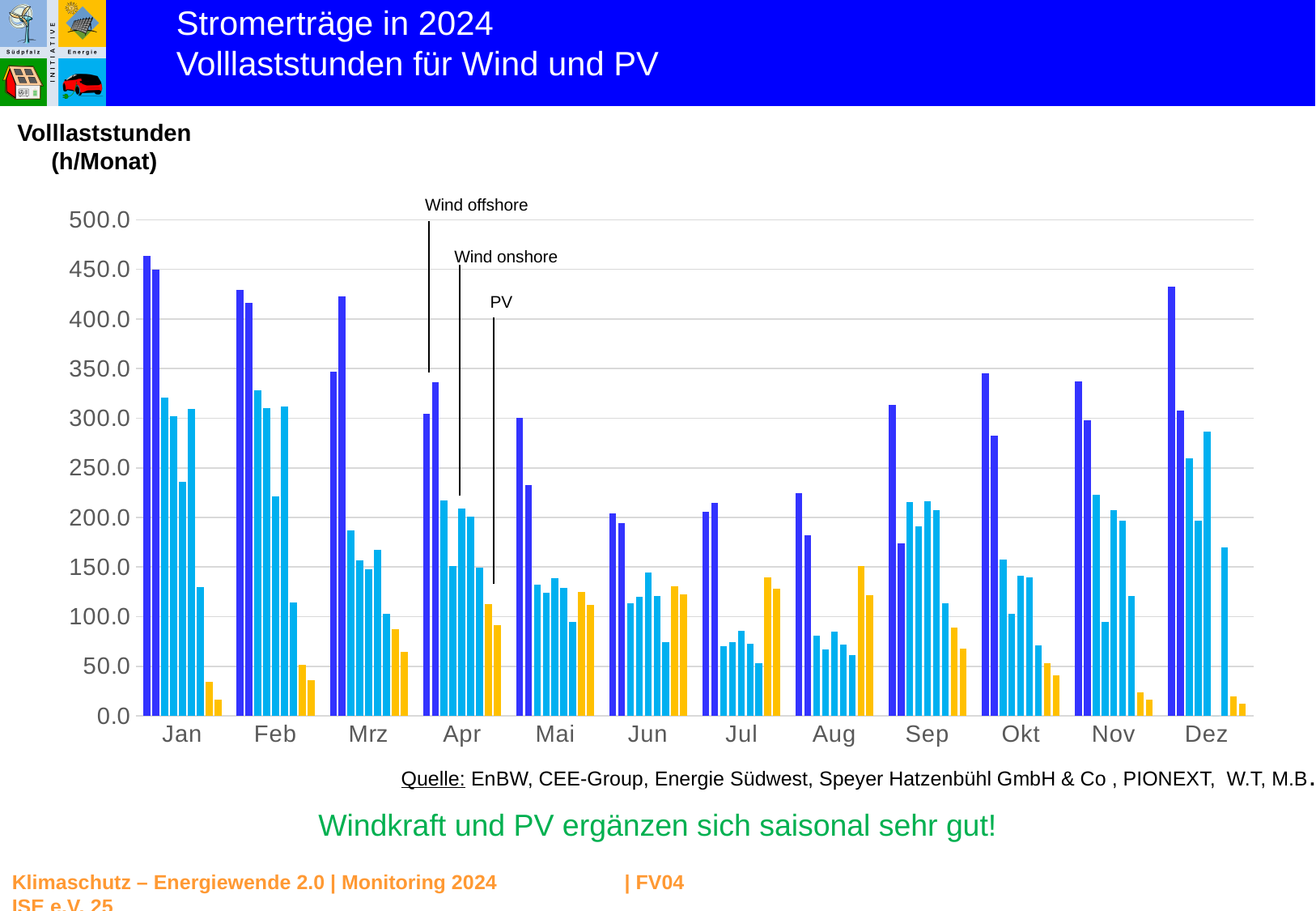
Do the PV bars rise or fall from Jan to Jun? rise Which month has higher PV bars, Jan or Jun? Jun Are the PV bars in Jan greater or less than 50? less What is the y-axis label of the chart? Volllaststunden (h/Monat) Is the tallest Wind offshore bar in Jan greater or less than 400? greater Which month contains the tallest bar in the chart? Jan Are the Wind offshore bars in Jul greater or less than 300? less How many months are shown along the x axis of the chart? 12 What are the three series labelled in the chart? Wind offshore, Wind onshore, PV What kind of chart is shown on the slide? bar chart How many series are labelled in the chart? 3 Which month has higher Wind offshore bars, Jan or Jul? Jan